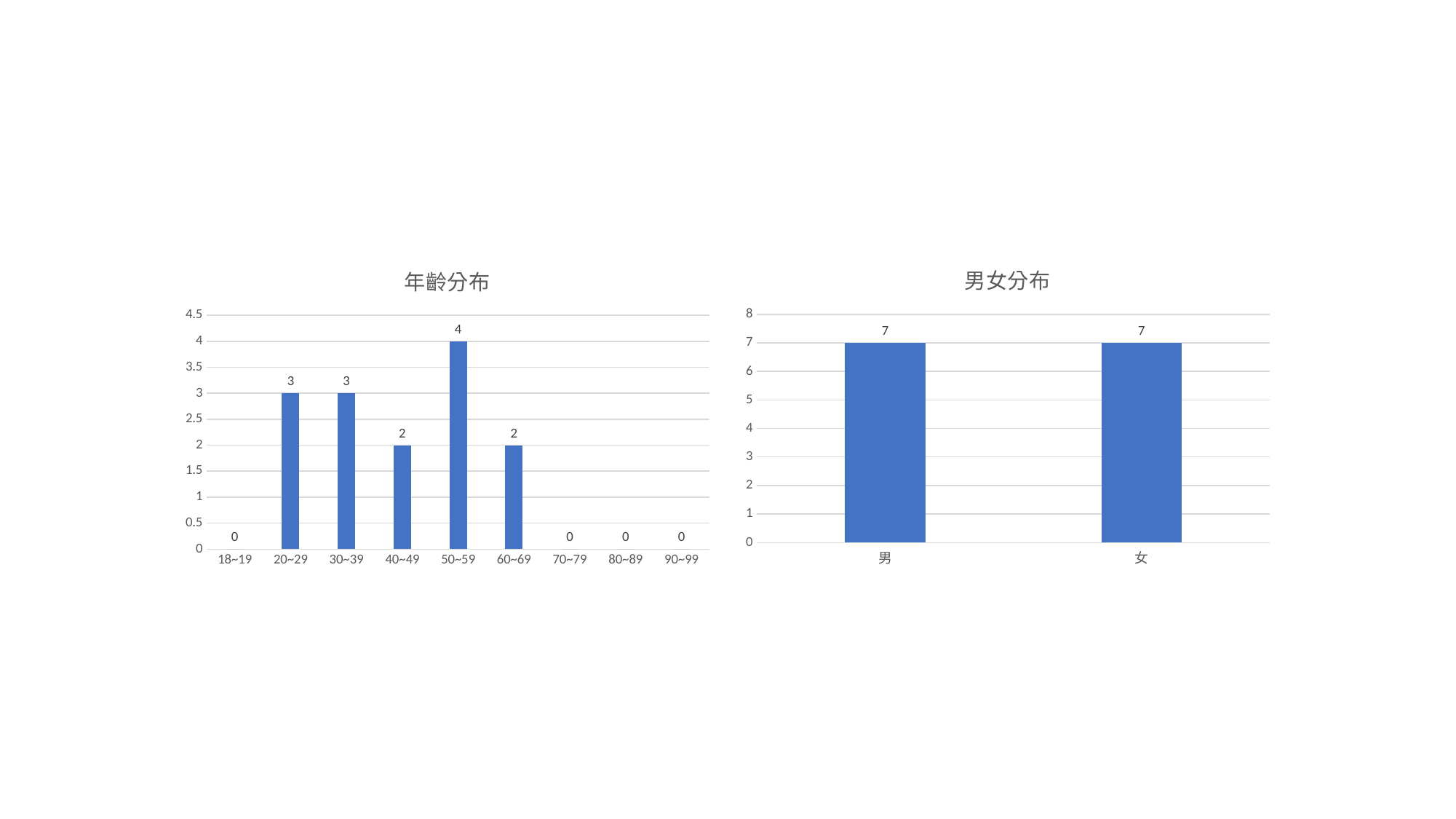
In the 年齢分布 chart, what is the value for 60~69? 2 In the 年齢分布 chart, what is the difference between the values for 50~59 and 40~49? 2 In the 年齢分布 chart, how many age groups have a value of 0? 4 In the 年齢分布 chart, what is the value for 50~59? 4 In the 年齢分布 chart, which age group has the highest value? 50~59 How many age groups are shown on the x axis of the 年齢分布 chart? 9 In the 年齢分布 chart, what is the value for 20~29? 3 In the 男女分布 chart, what is the value for 男? 7 In the 男女分布 chart, what is the total of the values for 男 and 女? 14 What is the title of the chart on the right side of the slide? 男女分布 In the 年齢分布 chart, which is larger, the value for 30~39 or the value for 60~69? 30~39 What kind of chart is the 年齢分布 chart? bar chart